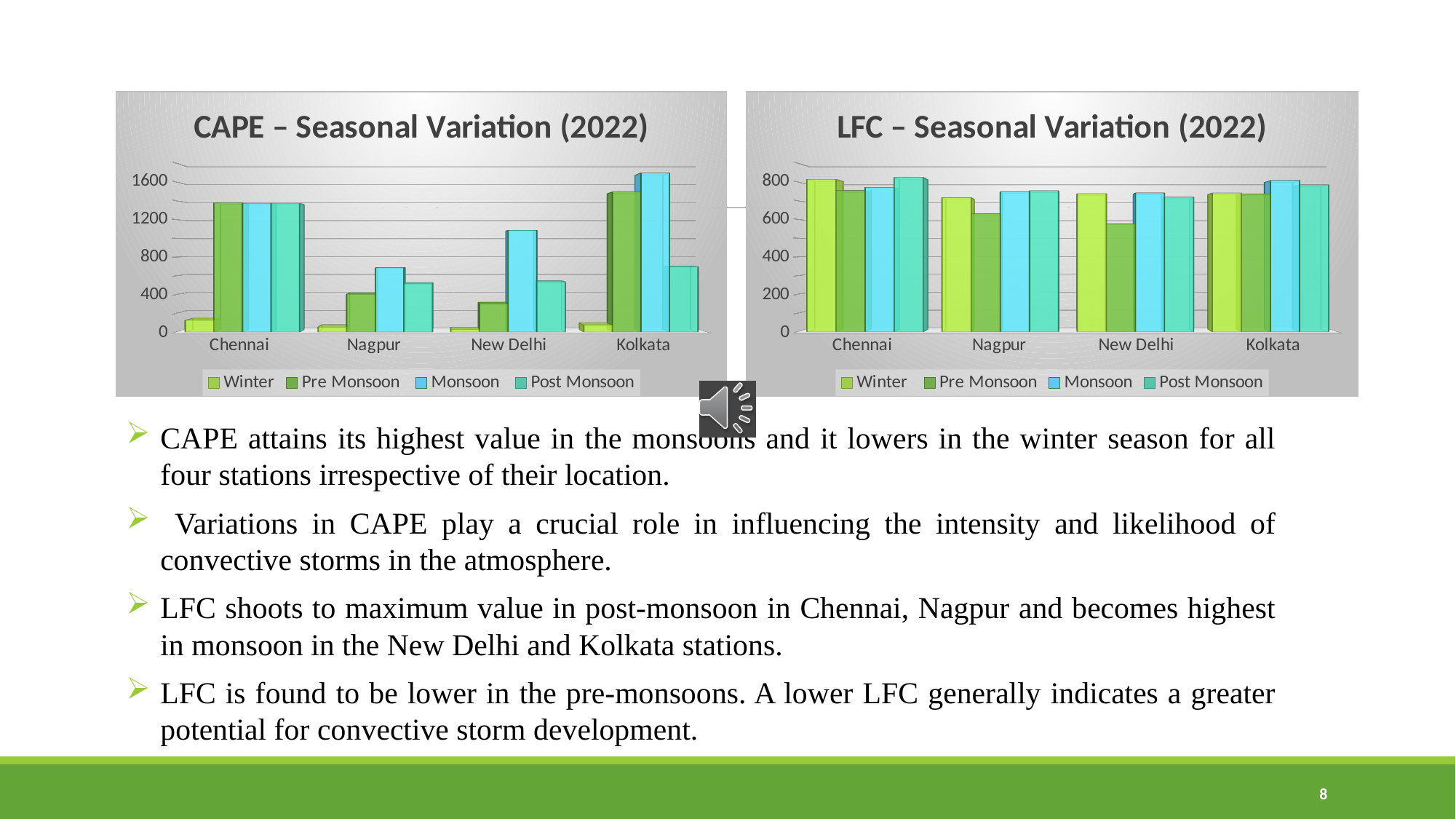
In the LFC – Seasonal Variation (2022) chart, which is larger for Kolkata: Monsoon or Pre Monsoon? Monsoon What is the title of the chart on the right of the slide? LFC – Seasonal Variation (2022) In the CAPE – Seasonal Variation (2022) chart, is the Monsoon value for New Delhi greater or less than 800? greater How many series does the legend of the CAPE – Seasonal Variation (2022) chart list? 4 What kind of chart is the CAPE – Seasonal Variation (2022) chart? bar chart In the CAPE – Seasonal Variation (2022) chart, which season has the lowest value for Kolkata? Winter How many stations are shown on the x axis of the LFC – Seasonal Variation (2022) chart? 4 In the LFC – Seasonal Variation (2022) chart, is the Pre Monsoon value for New Delhi greater or less than 600? less In the CAPE – Seasonal Variation (2022) chart, which is larger for Nagpur: Monsoon or Post Monsoon? Monsoon In the CAPE – Seasonal Variation (2022) chart, which station has the highest Monsoon value? Kolkata In the CAPE – Seasonal Variation (2022) chart, is the Winter value for Nagpur greater or less than 400? less In the LFC – Seasonal Variation (2022) chart, which season has the lowest value for Nagpur? Pre Monsoon